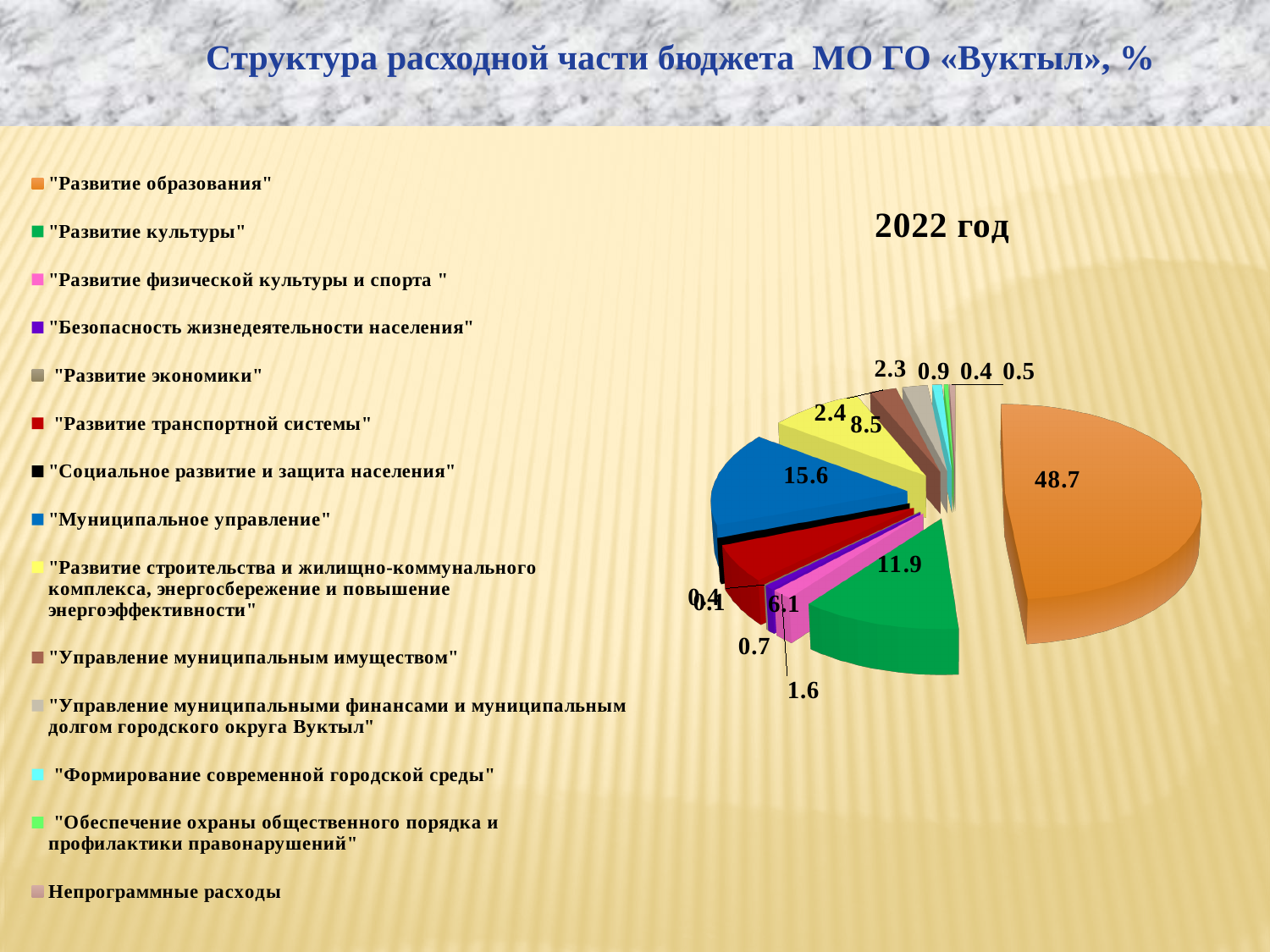
What is the value for "Развитие культуры" in the pie chart? 11.9 What is the difference between the values for "Развитие образования" and "Муниципальное управление"? 33.1 What is the value for "Развитие строительства и жилищно-коммунального комплекса, энергосбережение и повышение энергоэффективности" in the pie chart? 8.5 How many categories does the legend of the pie chart list? 14 What is the value for "Муниципальное управление" in the pie chart? 15.6 What type of chart is shown on the slide? pie chart What is the value for "Развитие образования" in the pie chart? 48.7 What is the value for "Развитие транспортной системы" in the pie chart? 6.1 Which is larger: the value for "Развитие культуры" or the value for "Развитие транспортной системы"? "Развитие культуры" What year is shown as the title above the pie chart? 2022 год Which category has the largest share of the pie chart? "Развитие образования" What is the difference between the values for "Муниципальное управление" and "Развитие культуры"? 3.7